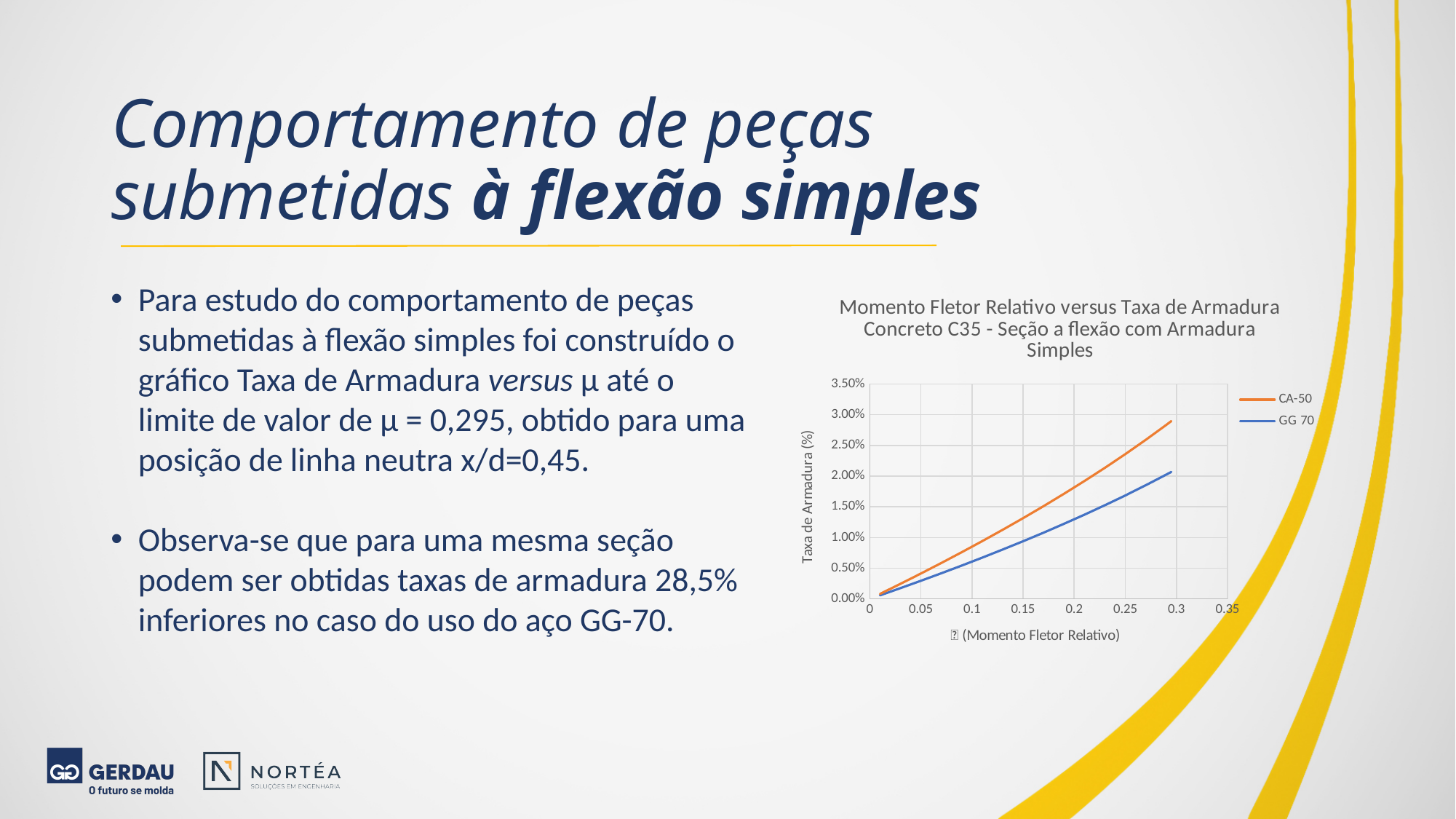
Is the value of the CA-50 series at x = 0.1 greater or less than 1.00%? less Do the values of the GG 70 series rise or fall as the x axis increases? rise Is the value of the CA-50 series at x = 0.25 greater or less than 2.00%? greater Which series is drawn in orange? CA-50 Which two series are listed in the chart legend? CA-50 and GG 70 Is the value of the GG 70 series at x = 0.3 greater or less than 2.50%? less At the right end of the lines (near x = 0.3), which series has the higher Taxa de Armadura, CA-50 or GG 70? CA-50 How many series does the chart legend list? 2 What kind of chart is shown on the slide? line chart Do the values of the CA-50 series rise or fall as the x axis increases? rise